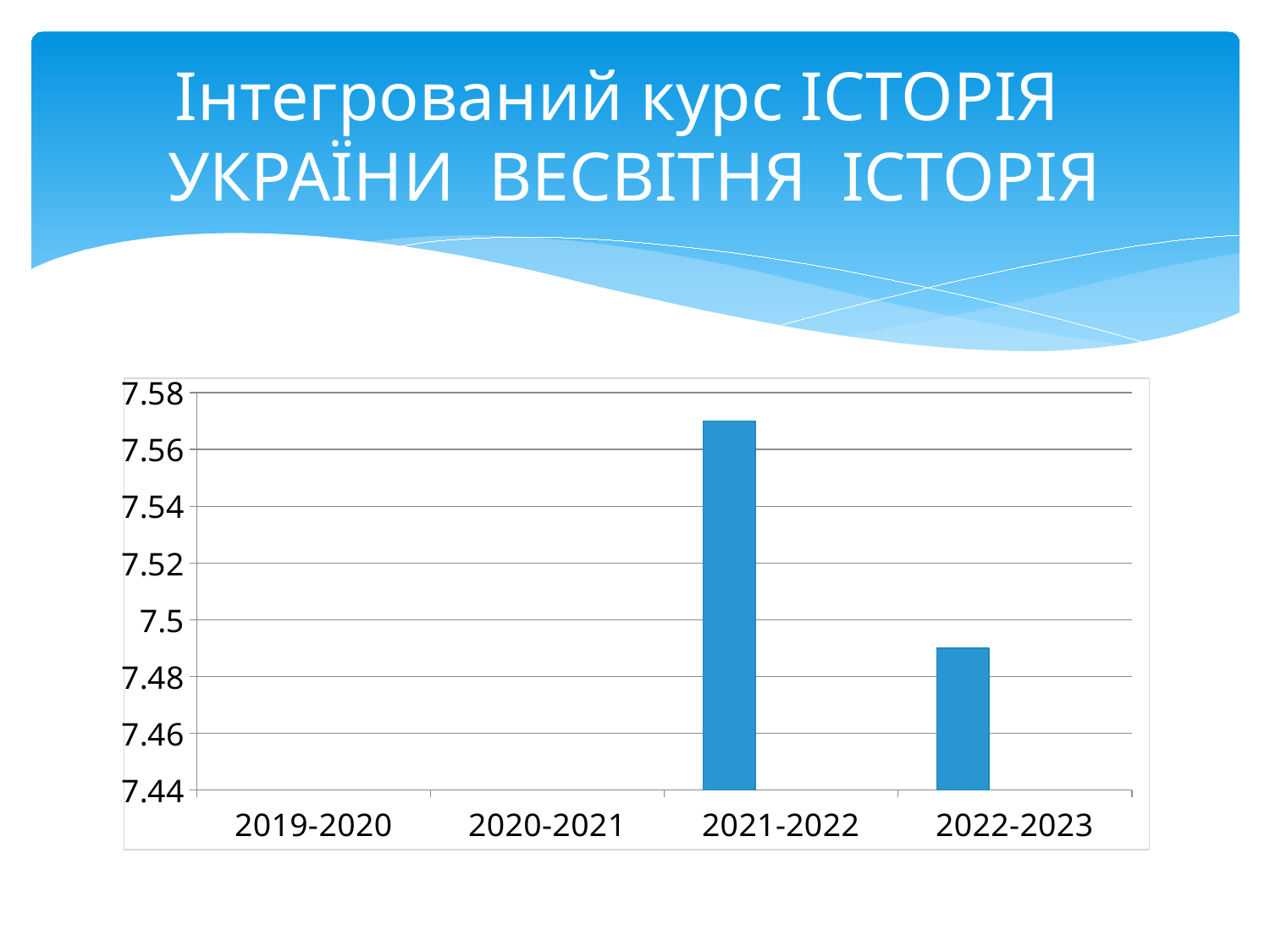
Which is larger, the value for 2021-2022 or the value for 2022-2023? 2021-2022 What kind of chart is shown on the slide? bar chart Is the value for 2022-2023 greater or less than 7.48? greater Is the value for 2022-2023 greater or less than 7.5? less How many categories are labelled on the x axis of the chart? 4 Is the value for 2021-2022 greater or less than 7.56? greater Which category has the highest bar in the chart? 2021-2022 Does the value rise or fall from 2021-2022 to 2022-2023? fall How many bars are actually plotted in the chart? 2 What is the lowest value shown on the y axis of the chart? 7.44 Which two x-axis categories have no bar plotted? 2019-2020 and 2020-2021